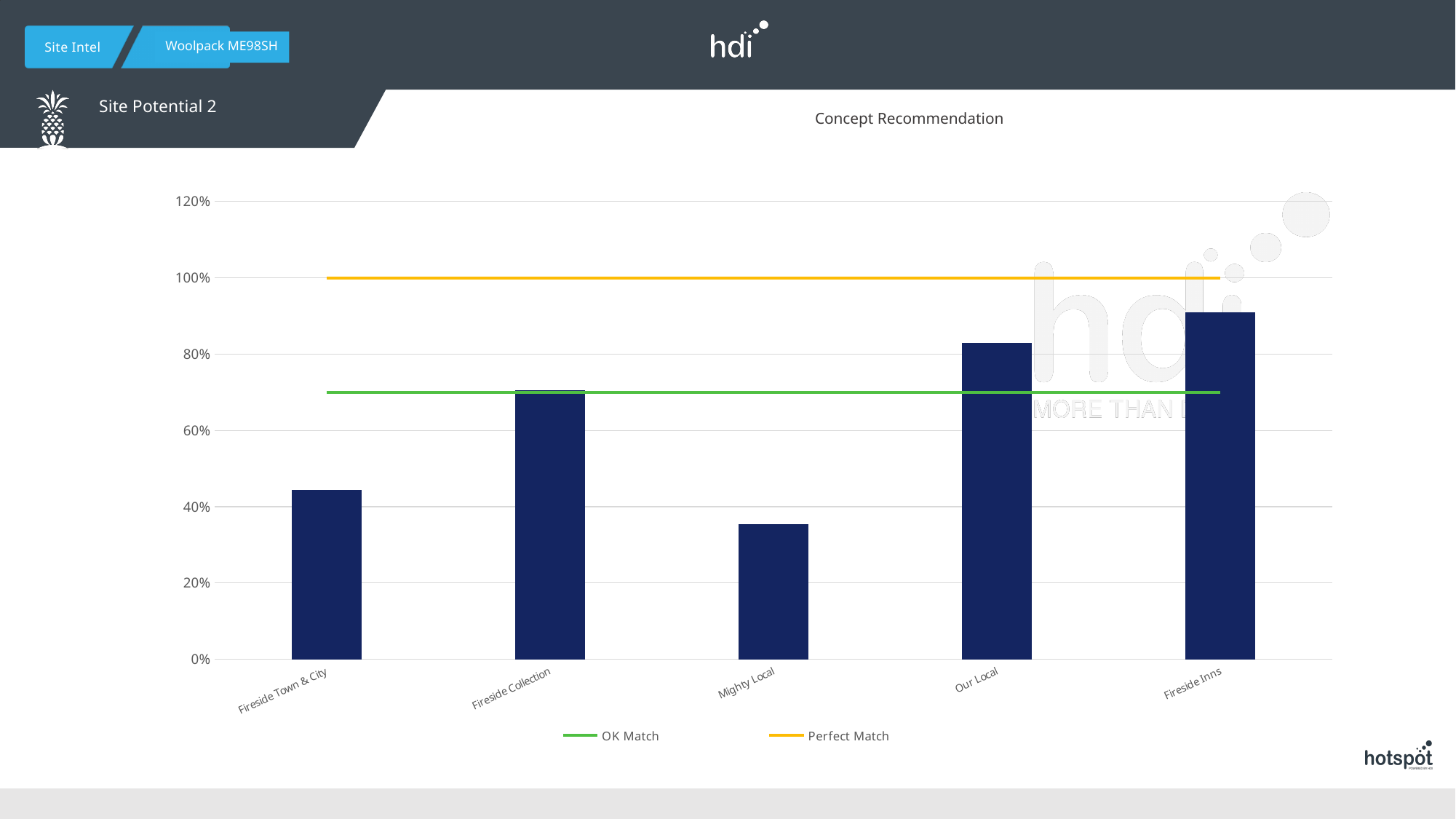
Which has the larger value, Fireside Collection or Mighty Local? Fireside Collection Which legend entry is drawn as a green line? OK Match How many categories are plotted along the x axis of the chart? 5 Which category has the highest bar in the chart? Fireside Inns How many entries does the chart's legend list? 2 Which category has the lowest bar in the chart? Mighty Local Is the value for Our Local greater or less than 80%? greater Which has the larger value, Our Local or Fireside Town & City? Our Local Is the value for Fireside Inns greater or less than 100%? less Is the value for Mighty Local greater or less than 40%? less What kind of chart is shown on the slide? bar chart